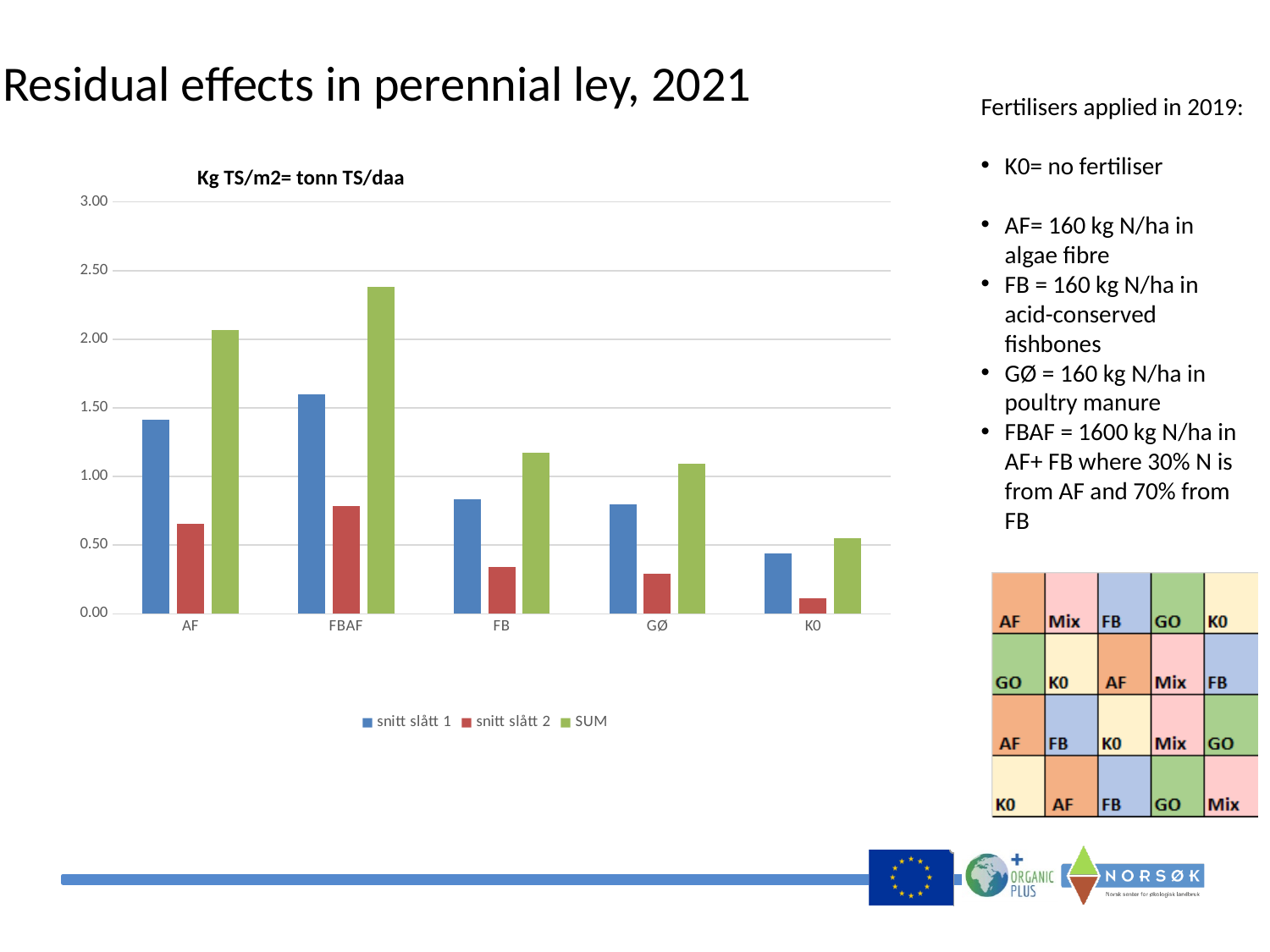
How many series does the chart legend list? 3 Which category has the highest value for snitt slått 1? FBAF How many categories are shown on the x axis of the chart? 5 Which category has the highest SUM value? FBAF What kind of chart is shown on the slide? bar chart Which is larger, the SUM value for AF or the SUM value for FB? AF What is the title of the chart? Kg TS/m2= tonn TS/daa Which category has the lowest SUM value? K0 Which category has the lowest value for snitt slått 2? K0 Is the SUM value for FBAF greater or less than 2.00? greater Is the snitt slått 2 value for K0 greater or less than 0.50? less Is the SUM value for FB greater or less than 1.00? greater